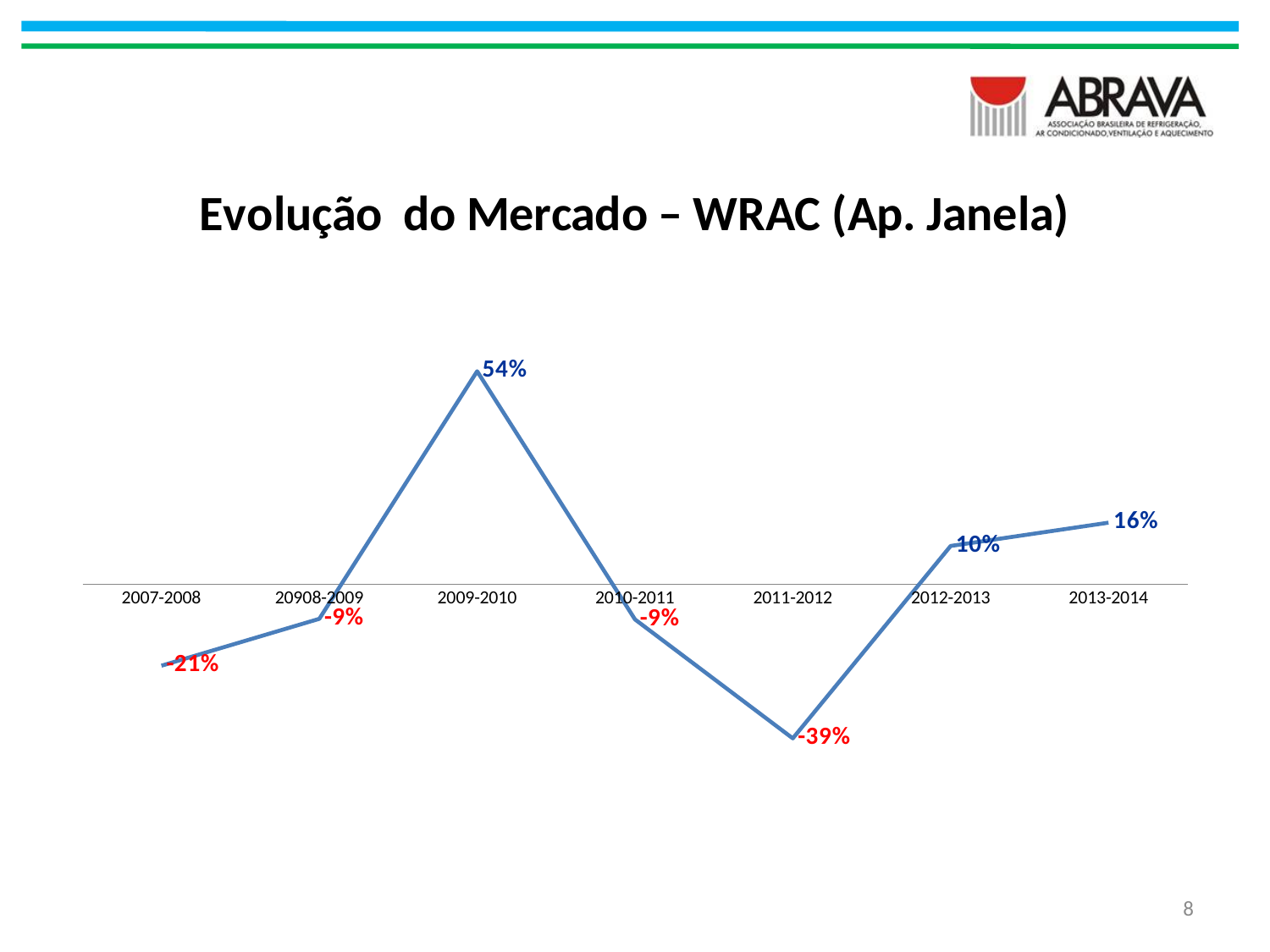
What is the value for 2009-2010? 54% What is the value for 2013-2014? 16% Which period has the highest value? 2009-2010 What is the title of the chart? Evolução do Mercado – WRAC (Ap. Janela) How many periods are plotted on the chart? 7 Which period has the lowest value? 2011-2012 What is the value for 2007-2008? -21% What kind of chart is shown on the slide? Line chart Which is larger, the value for 2007-2008 or the value for 2010-2011? 2010-2011 What is the value for 2012-2013? 10% What is the value for 2011-2012? -39% What is the difference between the values for 2013-2014 and 2012-2013? 6%